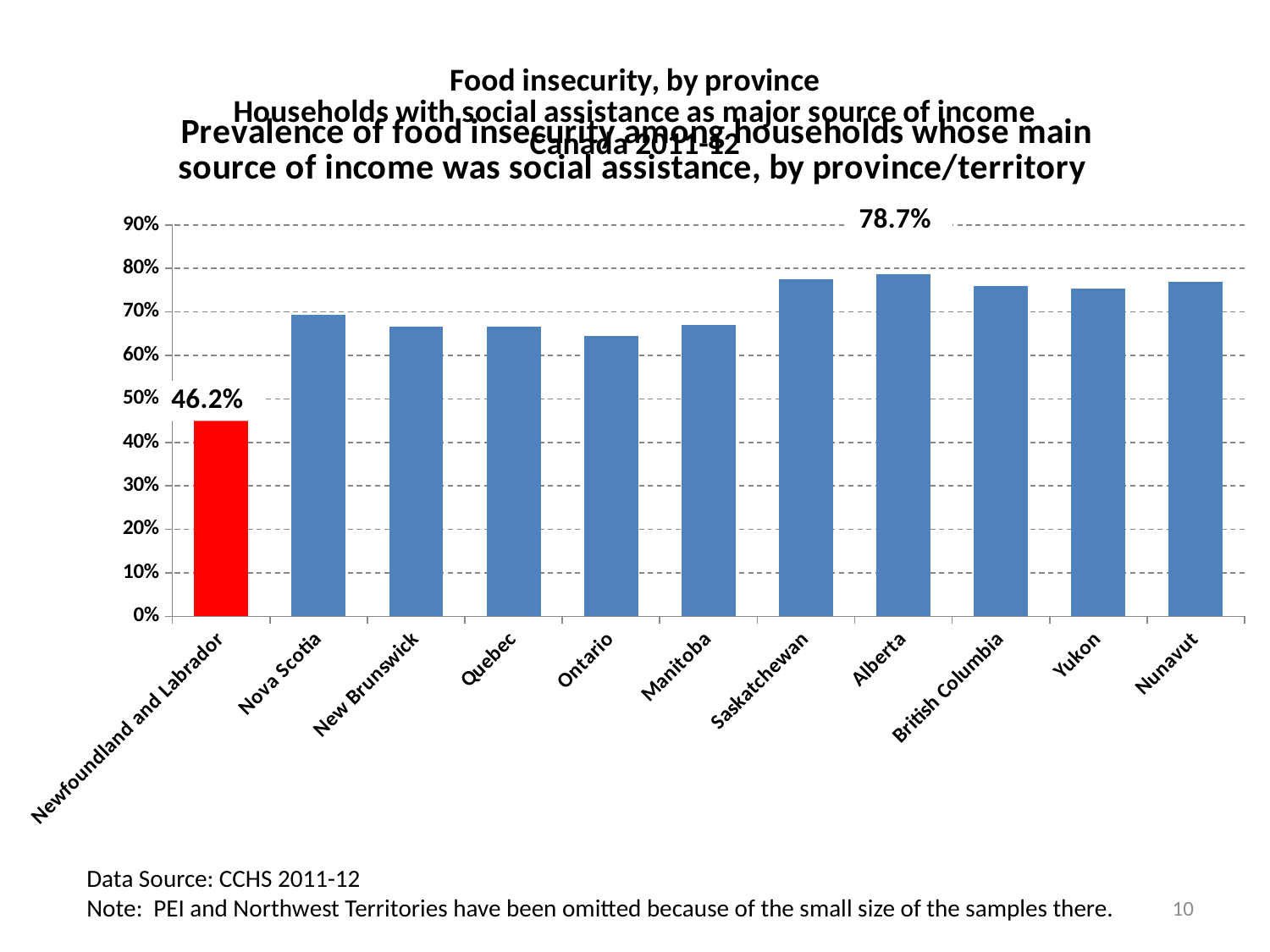
What is the value for Newfoundland and Labrador? 46.2% Which province or territory has the lowest prevalence of food insecurity? Newfoundland and Labrador What is the difference between the values for Alberta and Newfoundland and Labrador? 32.5 percentage points How many provinces and territories are shown on the chart? 11 Which province or territory's bar is coloured red? Newfoundland and Labrador Is the value for Ontario greater or less than 70%? less What is the value for Alberta? 78.7% Is the value for Yukon greater or less than 70%? greater Which province or territory has the highest prevalence of food insecurity? Alberta What kind of chart is shown on the slide? bar chart Which is larger, the value for Nova Scotia or the value for Ontario? Nova Scotia Is the value for Nova Scotia greater or less than 60%? greater